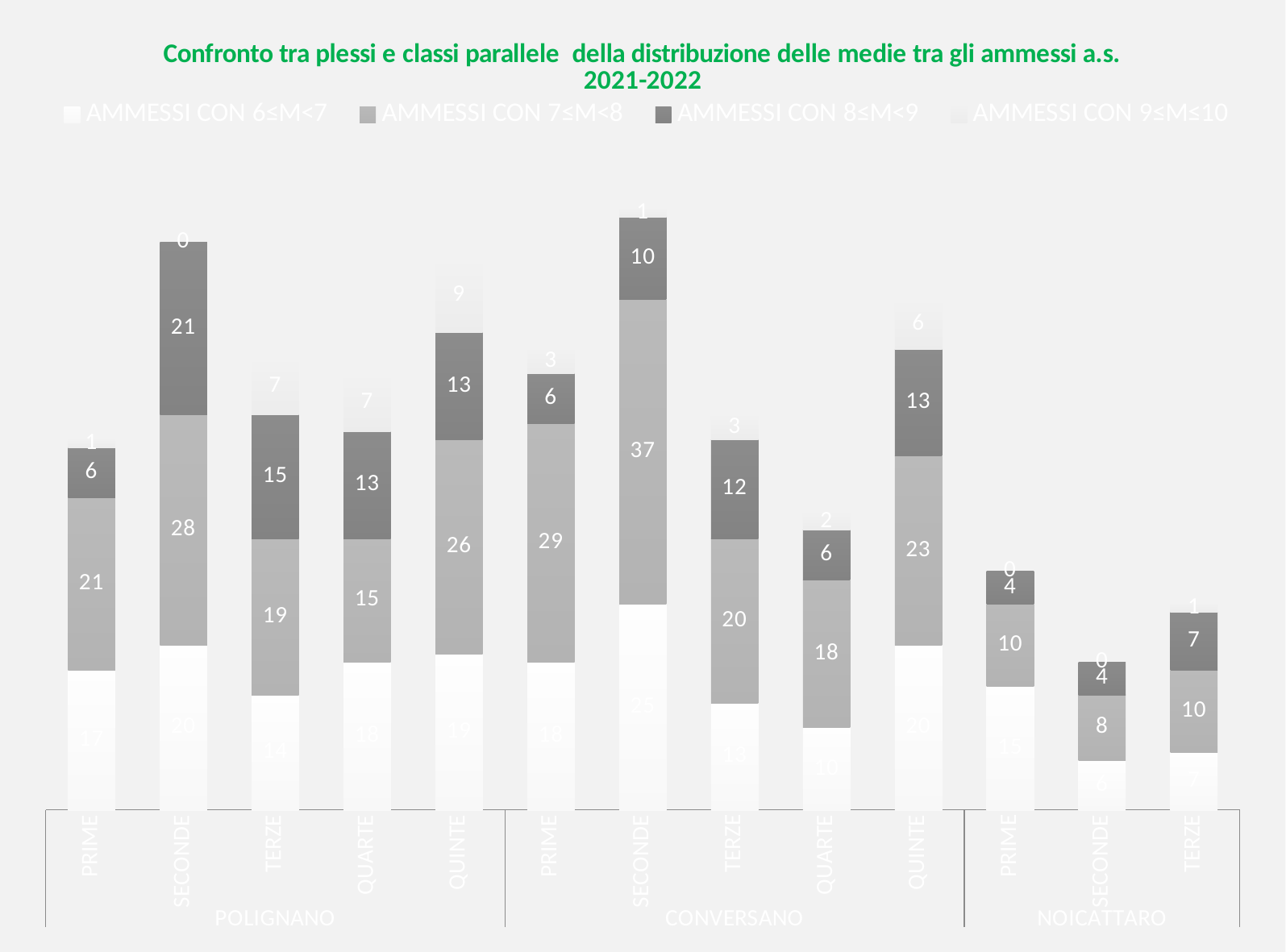
Which class group has the lowest value in the AMMESSI CON 7≤M<8 series? SECONDE of NOICATTARO What is the value of AMMESSI CON 8≤M<9 for the SECONDE classes of POLIGNANO? 21 Which has a larger AMMESSI CON 7≤M<8 value: the QUINTE classes of POLIGNANO or the PRIME classes of CONVERSANO? PRIME of CONVERSANO What is the total of the stacked bar for the QUINTE classes of POLIGNANO? 67 How many students are in the AMMESSI CON 7≤M<8 series for the SECONDE classes of CONVERSANO? 37 What is the difference between the AMMESSI CON 8≤M<9 values for the TERZE and QUARTE classes of POLIGNANO? 2 How many stacked bars are plotted in the chart? 13 What kind of chart is shown on the slide? Stacked bar chart Into how many school groups (plessi) are the bars divided along the x axis? 3 Which class group has the highest value in the AMMESSI CON 7≤M<8 series? SECONDE of CONVERSANO How many series does the legend list? 4 What is the value of AMMESSI CON 9≤M≤10 for the QUINTE classes of POLIGNANO? 9